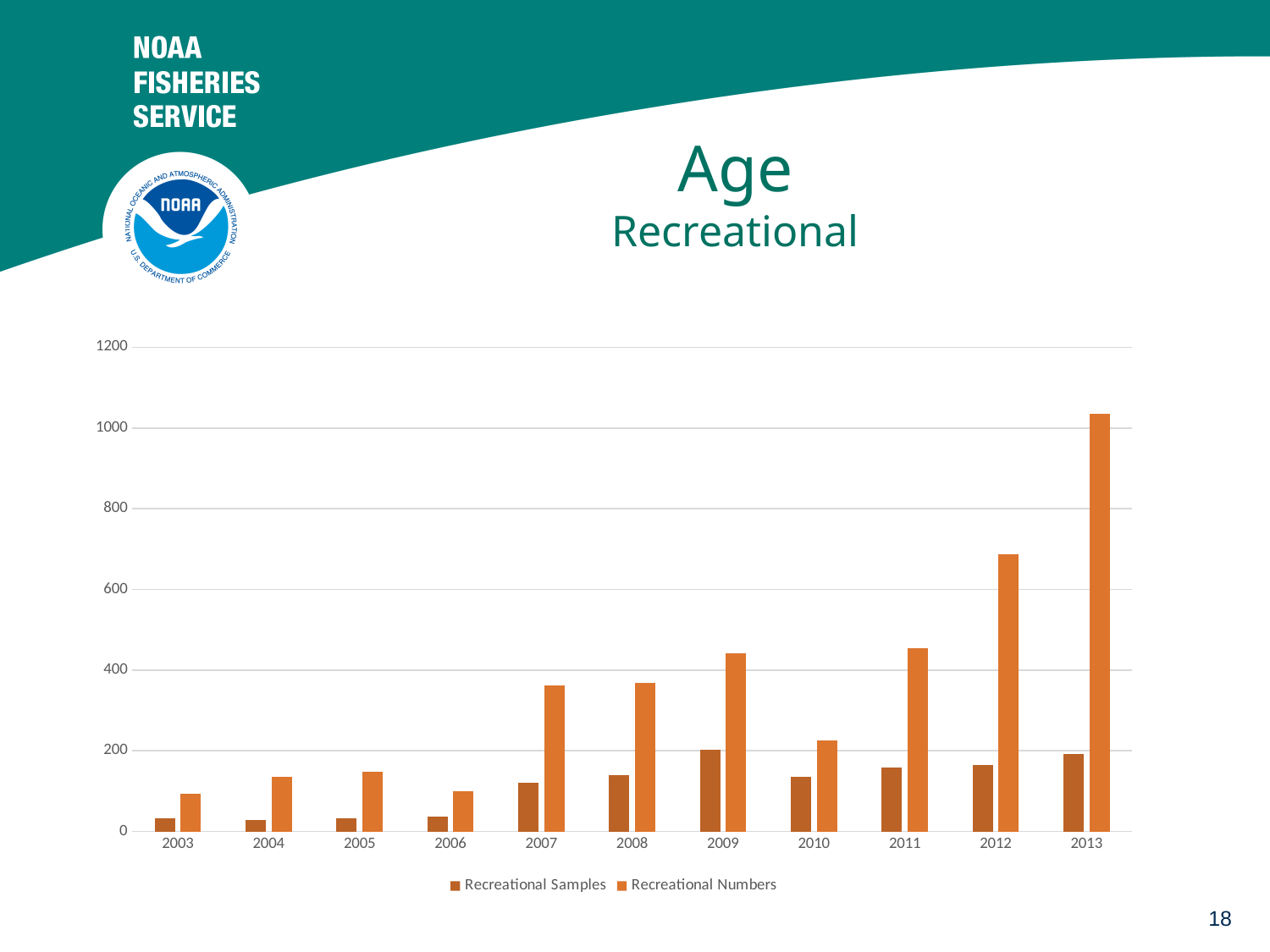
Is the value for Recreational Numbers in 2003 greater or less than 200? less What kind of chart is shown on the slide? bar chart Which year has the highest value for Recreational Numbers? 2013 How many series does the legend list? 2 Is the value for Recreational Numbers in 2012 greater or less than 600? greater How many years are shown on the x axis? 11 Which is larger, Recreational Numbers in 2009 or Recreational Numbers in 2010? 2009 Do the Recreational Numbers values generally rise or fall from 2003 to 2013? rise Which is larger, Recreational Numbers in 2011 or Recreational Numbers in 2012? 2012 Is the value for Recreational Samples in 2007 greater or less than 200? less What are the two series named in the legend? Recreational Samples and Recreational Numbers